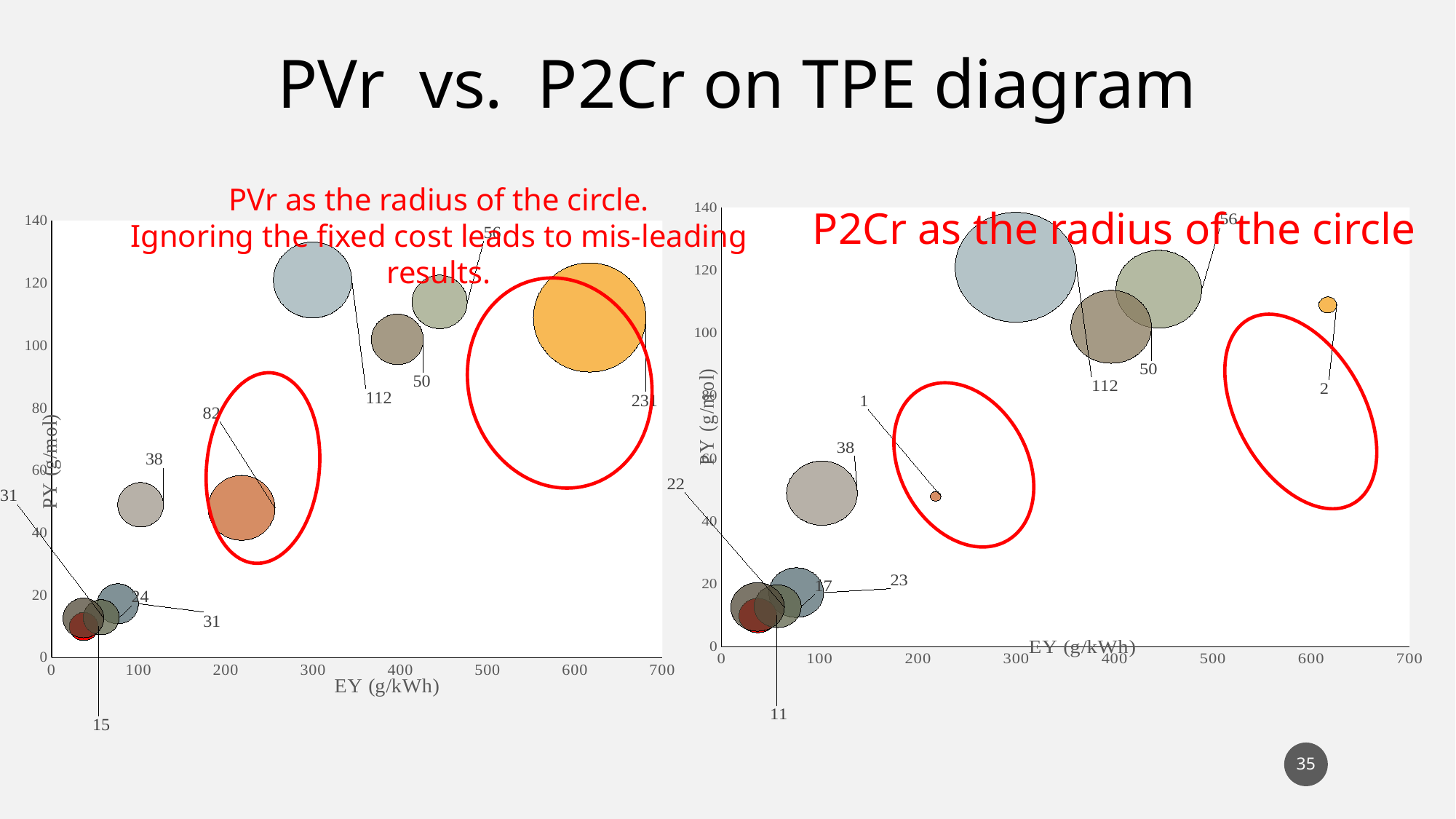
On the left chart (PVr as the radius), what is the label of the largest bubble? 231 On the right chart, do the PY values generally rise or fall as EY increases? rise On the right chart, what is the label of the smallest bubble? 1 What is the x-axis title of the charts? EY (g/kWh) What kind of chart is shown on the left side of the slide? Bubble chart On the right chart (P2Cr as the radius), what is the label of the largest bubble? 112 On the left chart, how many bubbles are plotted? 11 On the left chart, what is the difference between the bubble labels 231 and 82? 149 On the right chart, is the PY value of the bubble labelled 1 greater or less than 60? less On the left chart, is the PY value of the bubble labelled 231 greater or less than 100? greater On the right chart, is the EY value of the bubble labelled 2 greater or less than 500? greater